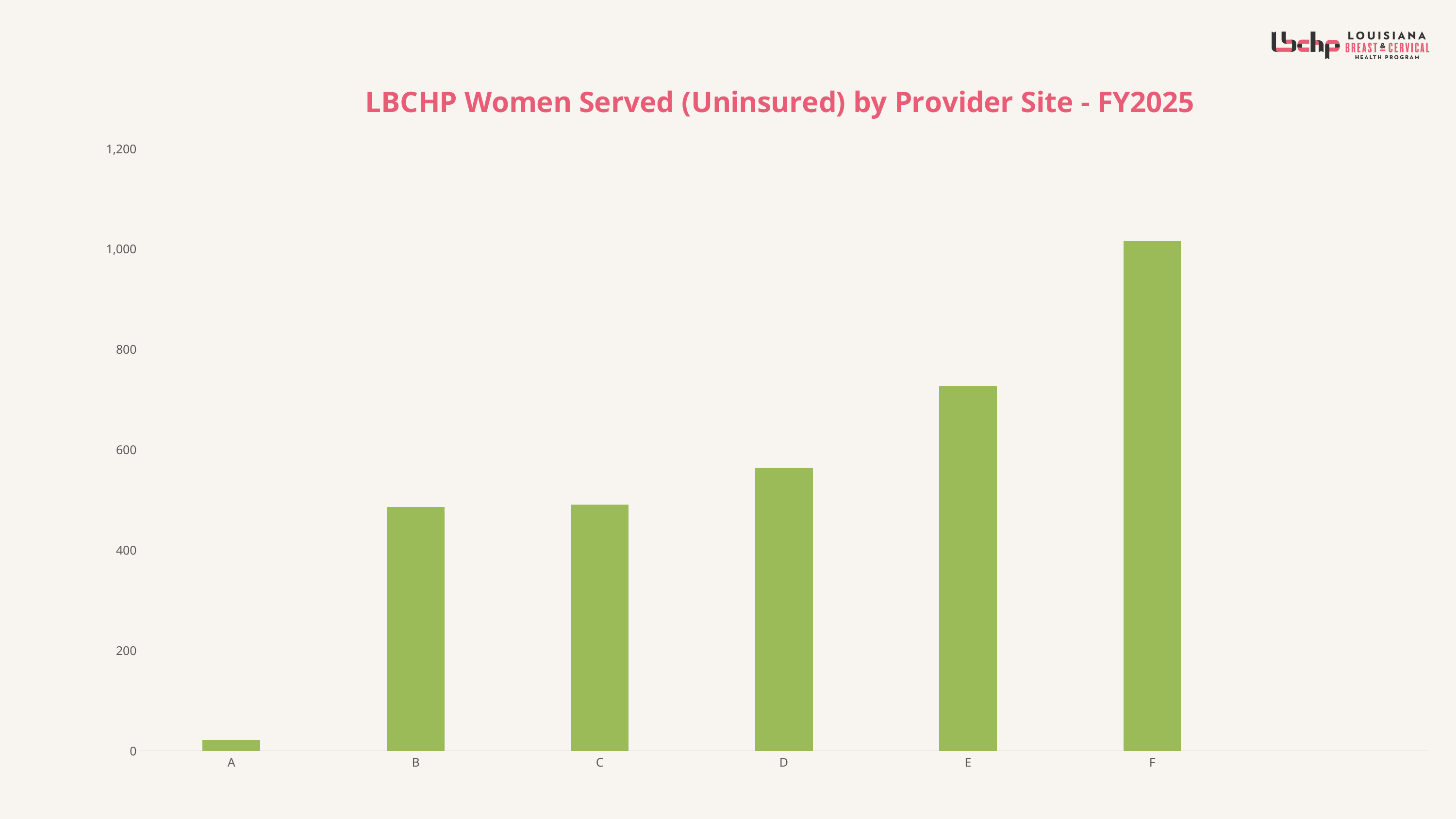
What kind of chart is shown on the slide? bar chart Is the value for site A greater or less than 200? less Which provider site has the highest number of uninsured women served? F Is the value for site D greater or less than 600? less How many provider sites are shown on the x axis? 6 What is the title of the chart? LBCHP Women Served (Uninsured) by Provider Site - FY2025 Is the value for site E greater or less than 800? less Do the values rise or fall moving from site A to site F along the x axis? rise Which provider site has the lowest number of uninsured women served? A Which is larger, the value for site E or the value for site D? E Which is larger, the value for site B or the value for site D? D